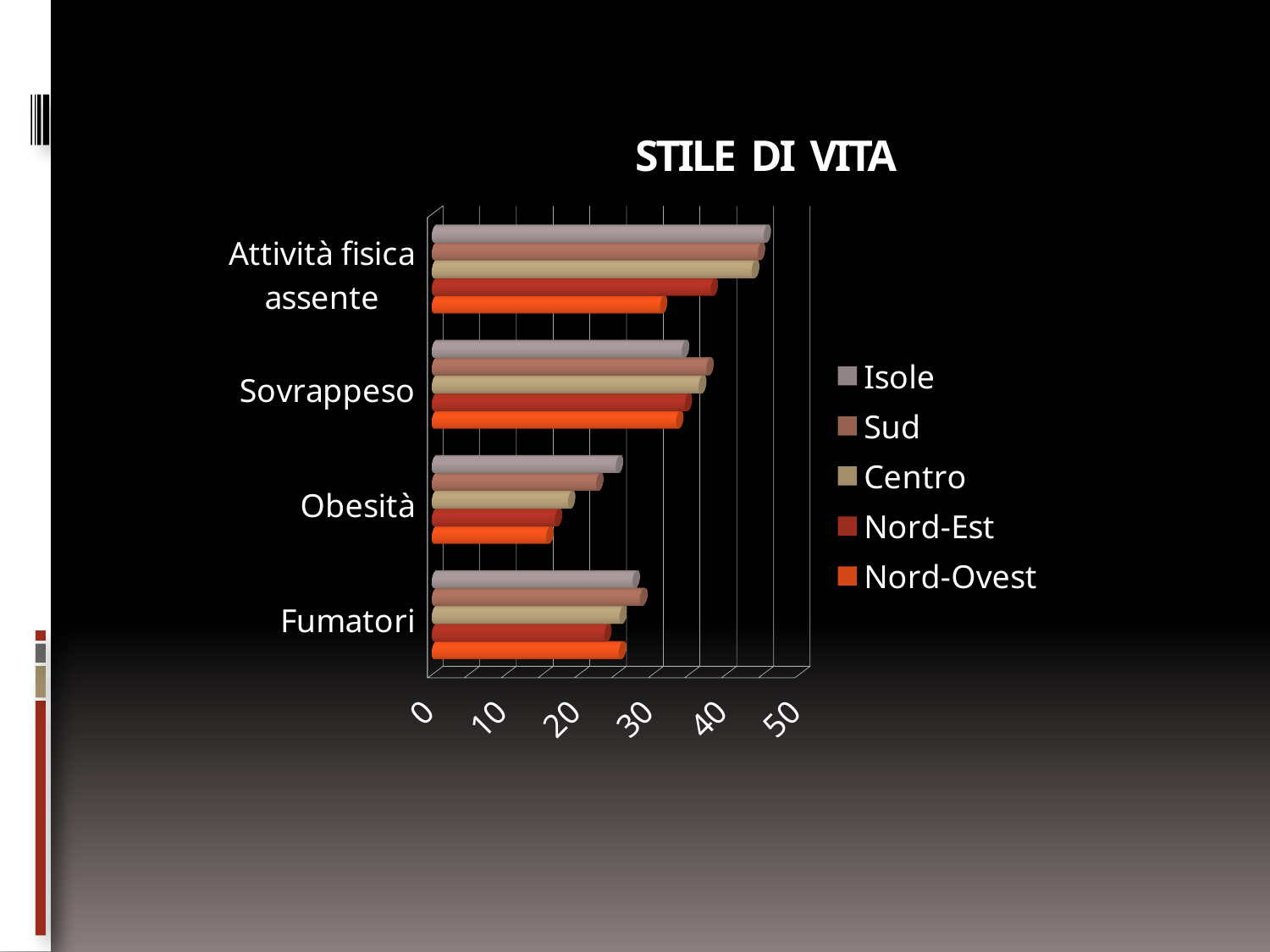
In Attività fisica assente, which is larger: the value for Isole or the value for Nord-Ovest? Isole What is the title of the chart? STILE DI VITA Is the value for Sud in Sovrappeso greater or less than 40? less Is the value for Isole in Attività fisica assente greater or less than 40? greater Is the value for Nord-Ovest in Obesità greater or less than 20? less Which series are listed in the legend? Isole, Sud, Centro, Nord-Est, Nord-Ovest How many series does the legend list? 5 For the Isole series, which category has the highest value? Attività fisica assente For the Nord-Ovest series, which category has the lowest value? Obesità What kind of chart is shown on the slide? bar chart How many categories are shown on the chart? 4